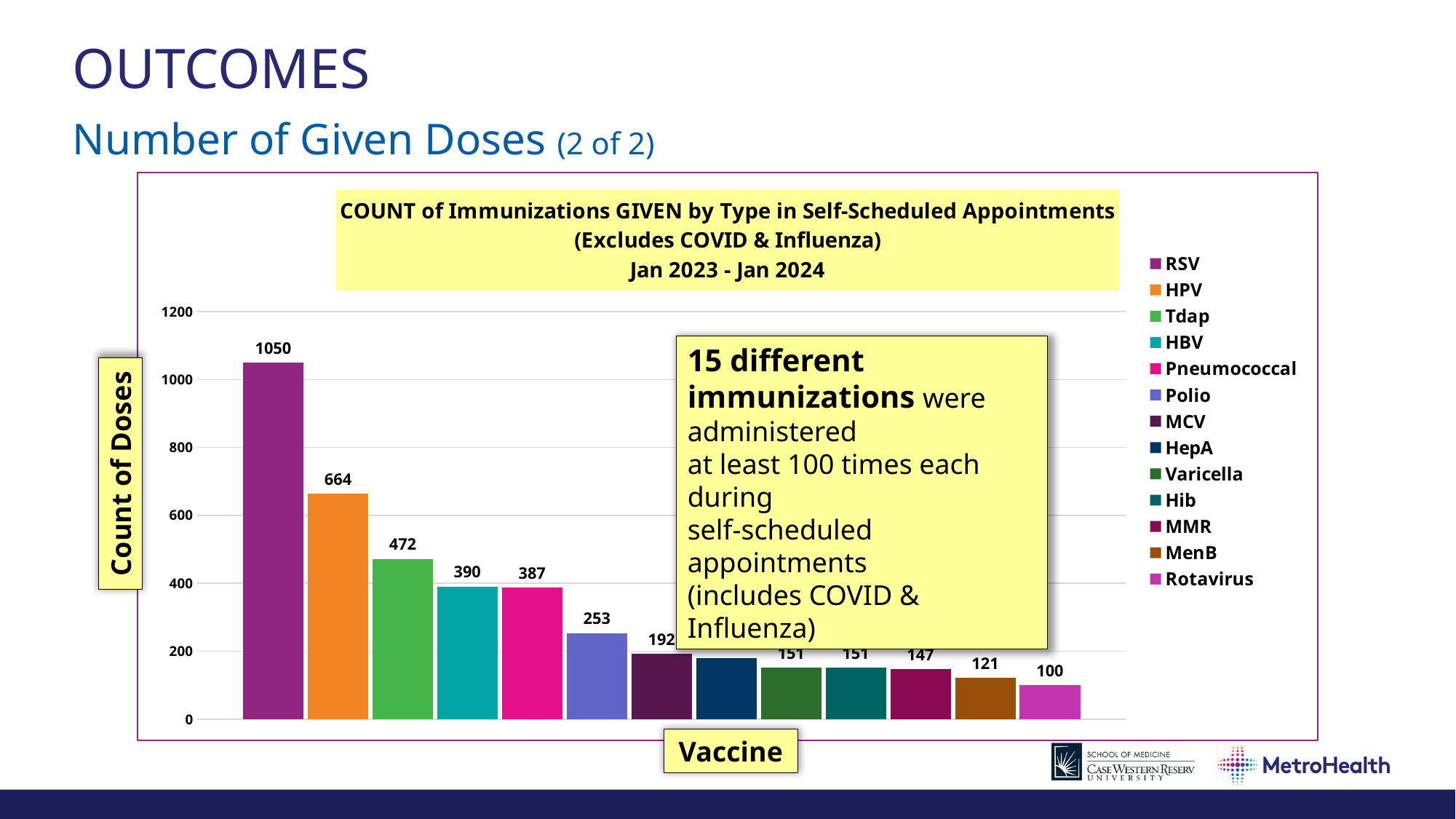
How many vaccine bars are plotted in the chart? 13 What kind of chart is shown on the slide? Bar chart Is the value for HepA greater or less than 200? less How many doses of HPV were given? 664 What is the difference between the RSV and HPV dose counts? 386 Do the dose counts rise or fall from left to right along the x axis? Fall What is the count of doses for RSV? 1050 Which vaccine has the highest count of doses? RSV What is the count of doses for Polio? 253 What is the value shown for Rotavirus? 100 Which has more doses, Tdap or HBV? Tdap Which vaccine has the lowest count of doses? Rotavirus